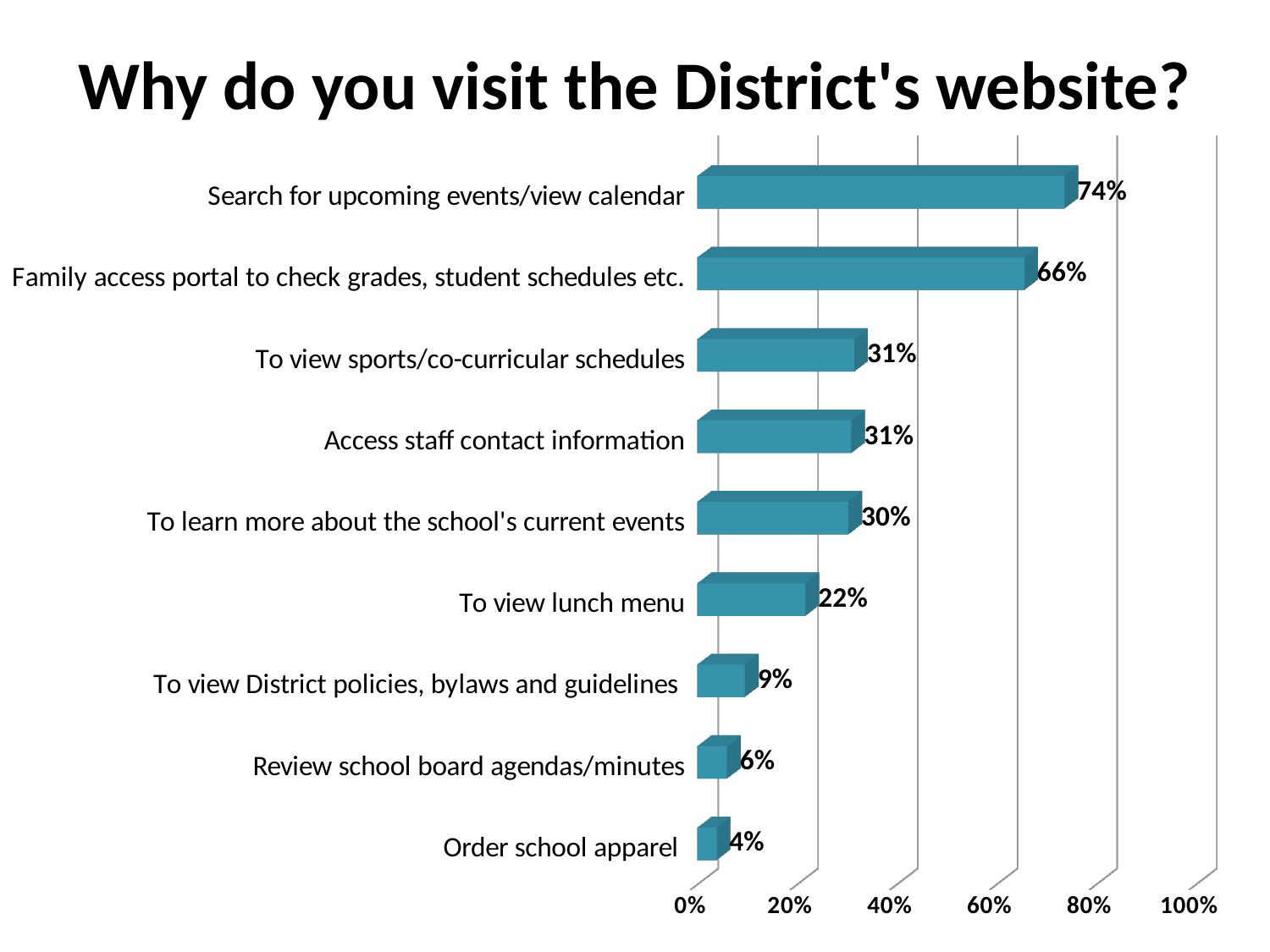
What kind of chart is shown on the slide? Bar chart What is the difference between 'To view lunch menu' and 'To view District policies, bylaws and guidelines'? 13% Is the value for 'Family access portal to check grades, student schedules etc.' greater or less than 60%? greater What percentage of respondents visit the District's website to search for upcoming events/view calendar? 74% What is the value for 'To view lunch menu'? 22% What is the value for 'Review school board agendas/minutes'? 6% Which reason for visiting the District's website has the lowest percentage? Order school apparel How many categories (reasons) are shown in the chart? 9 Which reason for visiting the District's website has the highest percentage? Search for upcoming events/view calendar Which is larger: the value for 'To view lunch menu' or the value for 'To learn more about the school's current events'? To learn more about the school's current events What is the difference between the percentage for 'Search for upcoming events/view calendar' and 'Family access portal to check grades, student schedules etc.'? 8% What is the title of the chart? Why do you visit the District's website?